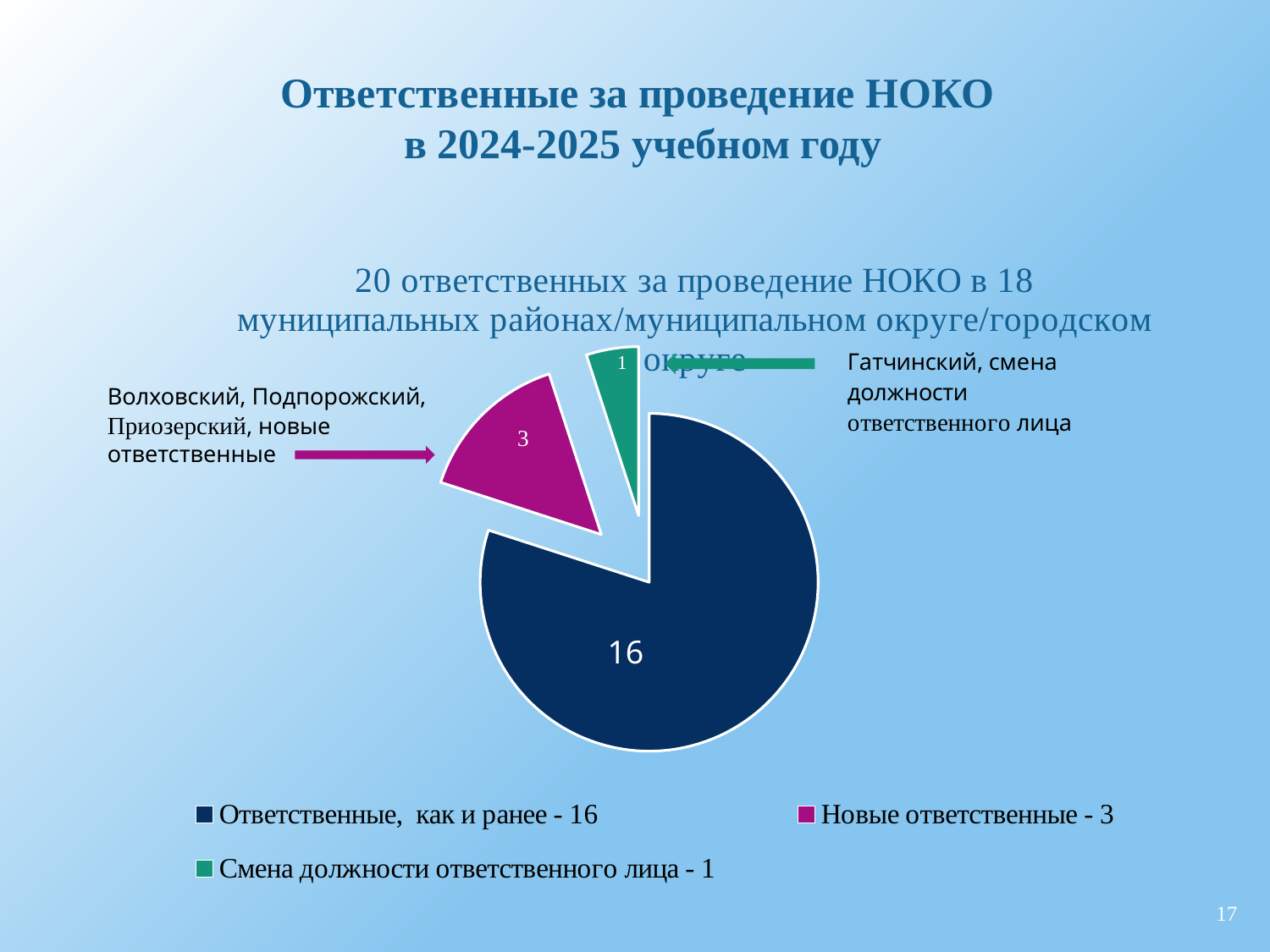
What is the difference between the 'Ответственные, как и ранее' slice and the 'Новые ответственные' slice? 13 What is the value of the slice for 'Новые ответственные'? 3 What is the value of the slice for 'Ответственные, как и ранее'? 16 Which category has the smallest slice in the pie chart? Смена должности ответственного лица What is the value of the slice for 'Смена должности ответственного лица'? 1 Which category has the largest slice in the pie chart? Ответственные, как и ранее What kind of chart is shown on the slide? Pie chart Which is larger: the 'Новые ответственные' slice or the 'Смена должности ответственного лица' slice? Новые ответственные How many entries does the legend of the pie chart list? 3 Which districts are named as having new responsible persons (новые ответственные)? Волховский, Подпорожский, Приозерский What share of the pie does the 'Ответственные, как и ранее' slice represent? 80% How many slices does the pie chart have? 3